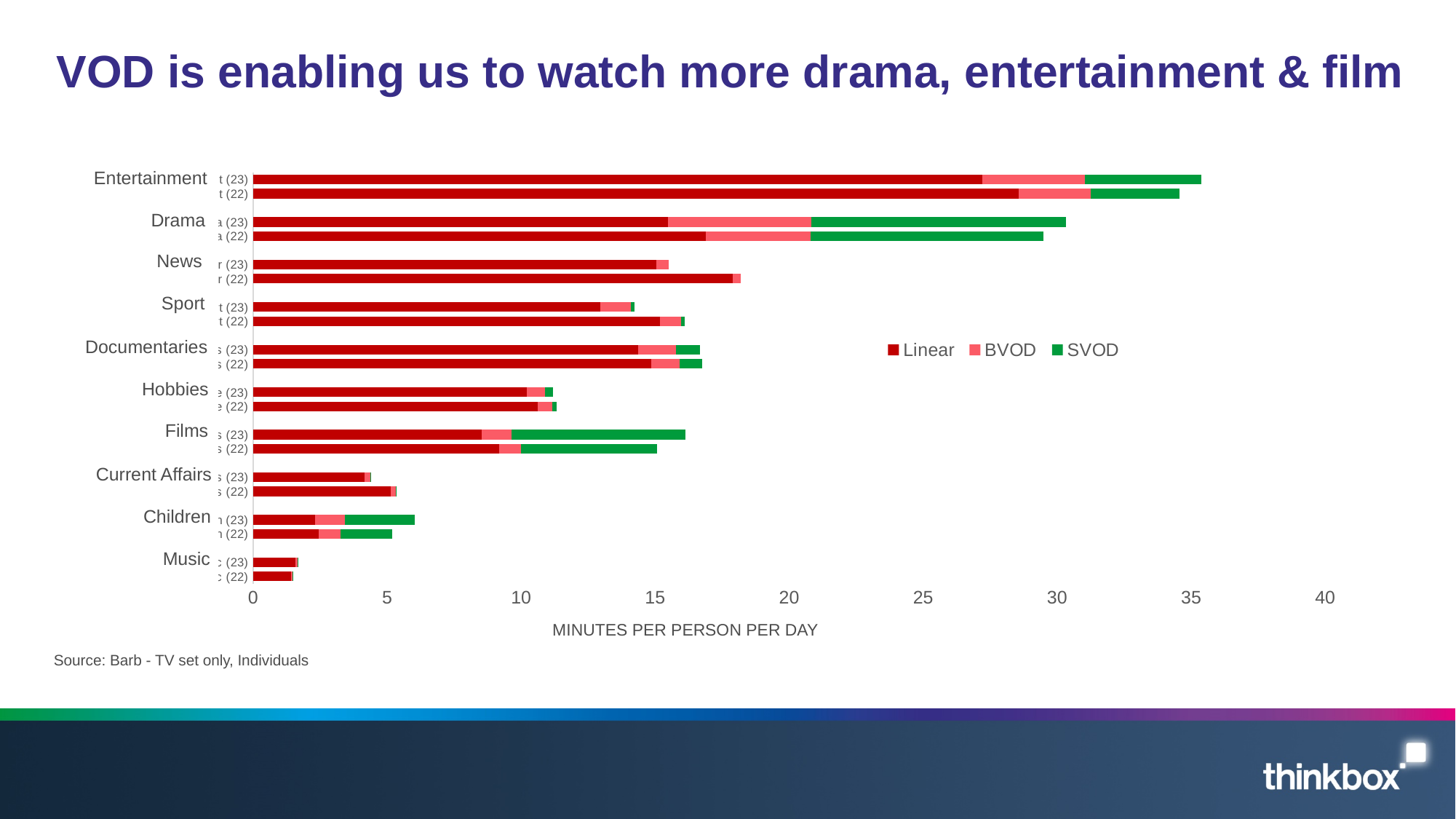
How many genre categories are shown on the chart? 10 What are the three series named in the legend? Linear, BVOD, SVOD How many series does the legend list? 3 Which has the larger total, Films (23) or Films (22)? Films (23) Which bar is the shortest on the chart? Music (22) Is the total value for Current Affairs (23) greater or less than 5? less Which bar is the longest on the chart? Entertainment (23) Is the total value for Entertainment (23) greater or less than 30? greater What is the title of the horizontal axis? MINUTES PER PERSON PER DAY Is the total value for News (22) greater or less than 15? greater What kind of chart is shown on the slide? Stacked bar chart Which has the larger total, News (22) or News (23)? News (22)